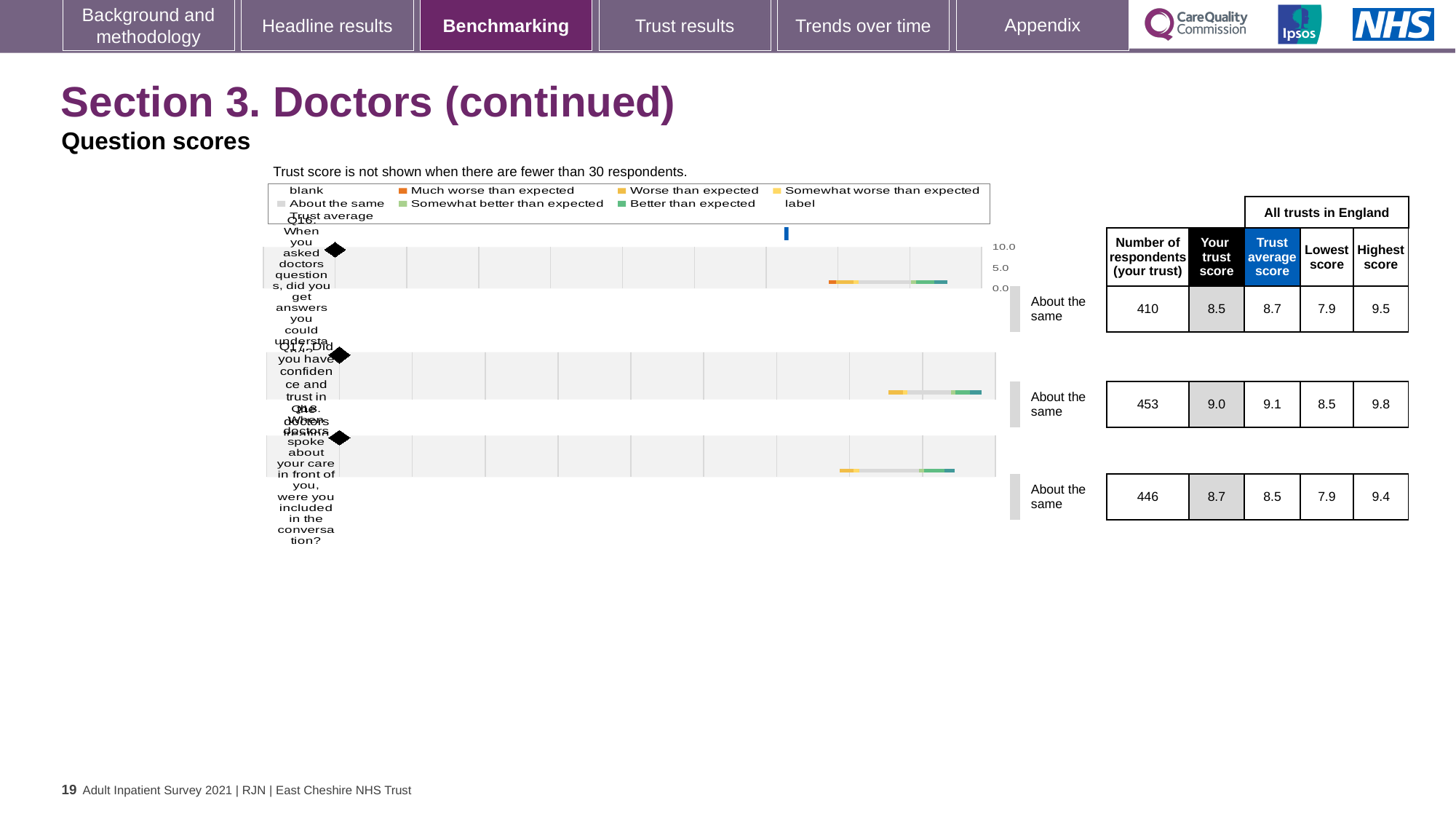
What is the difference between the highest score (9.8) and the lowest score (8.5) for Q17? 1.3 How many respondents from your trust answered Q17? 453 What is the 'Your trust score' for Q16 (When you asked doctors questions, did you get answers you could understand)? 8.5 What kind of chart is used to show the question scores on this slide? bar chart Which question has the lowest 'Your trust score'? Q16 How many questions (Q16, Q17, Q18) are plotted on the slide? 3 What is the trust average score for Q18 (When doctors spoke about your care in front of you, were you included in the conversation)? 8.5 What is the 'Your trust score' for Q17 (Did you have confidence and trust in the doctors treating you)? 9.0 Which question has the highest 'Your trust score'? Q17 For Q16, which is larger: your trust score or the trust average score? trust average score What benchmark category is shown for Q18? About the same What is the highest score across all trusts in England for Q17? 9.8